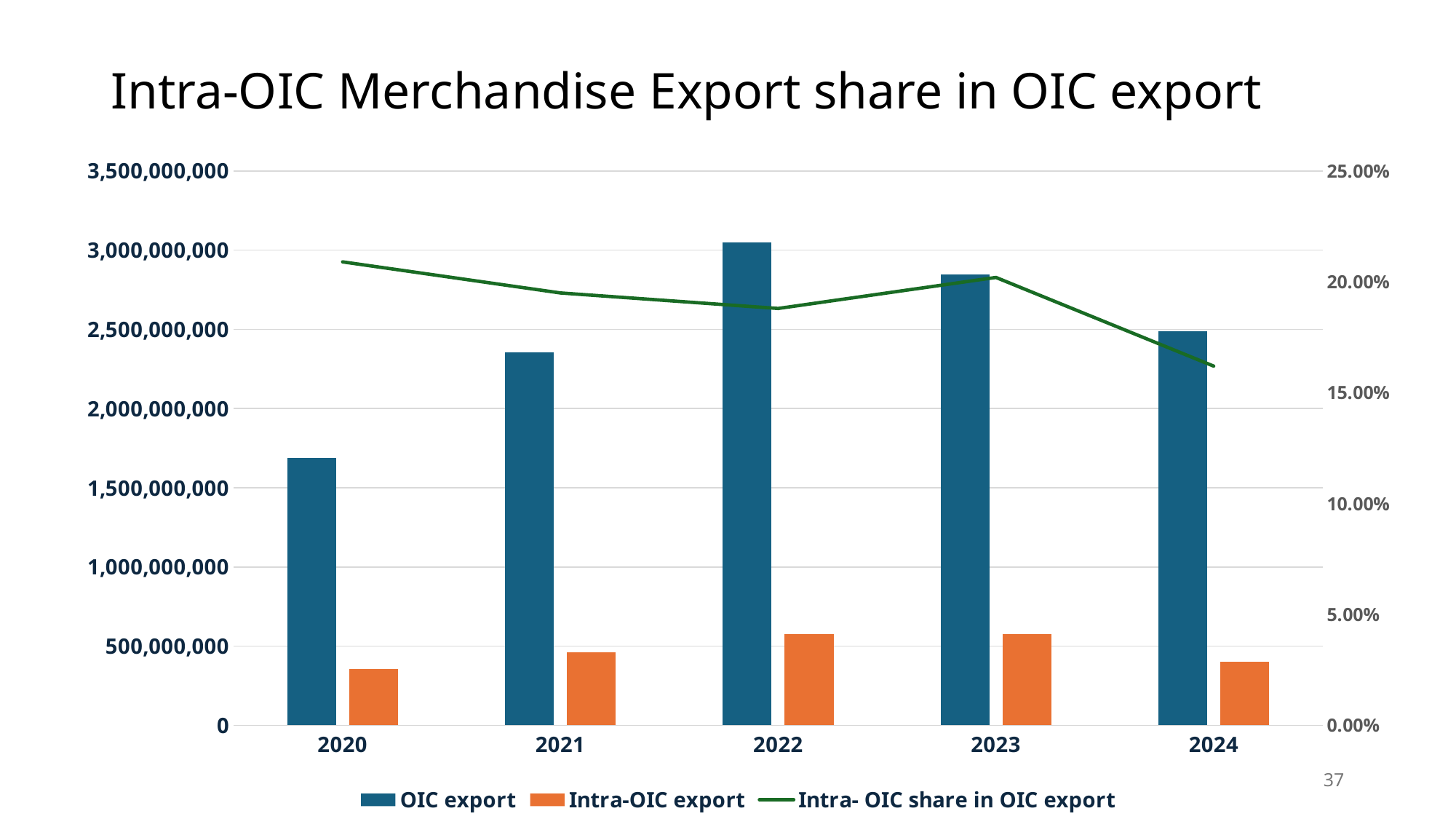
Is the OIC export value for 2021 greater or less than 2,500,000,000? less In which year is the Intra-OIC share in OIC export highest? 2020 In which year is Intra-OIC export lowest? 2020 In which year is OIC export highest? 2022 Which is larger, OIC export in 2023 or OIC export in 2024? OIC export in 2023 Is the Intra-OIC export value for 2022 greater or less than 500,000,000? greater How many series does the legend list? 3 How many years are shown on the x axis? 5 What kind of chart is shown on the slide? A combined bar and line chart Is the Intra-OIC share in OIC export for 2024 greater or less than 15.00%? greater In which year is OIC export lowest? 2020 In which year is the Intra-OIC share in OIC export lowest? 2024